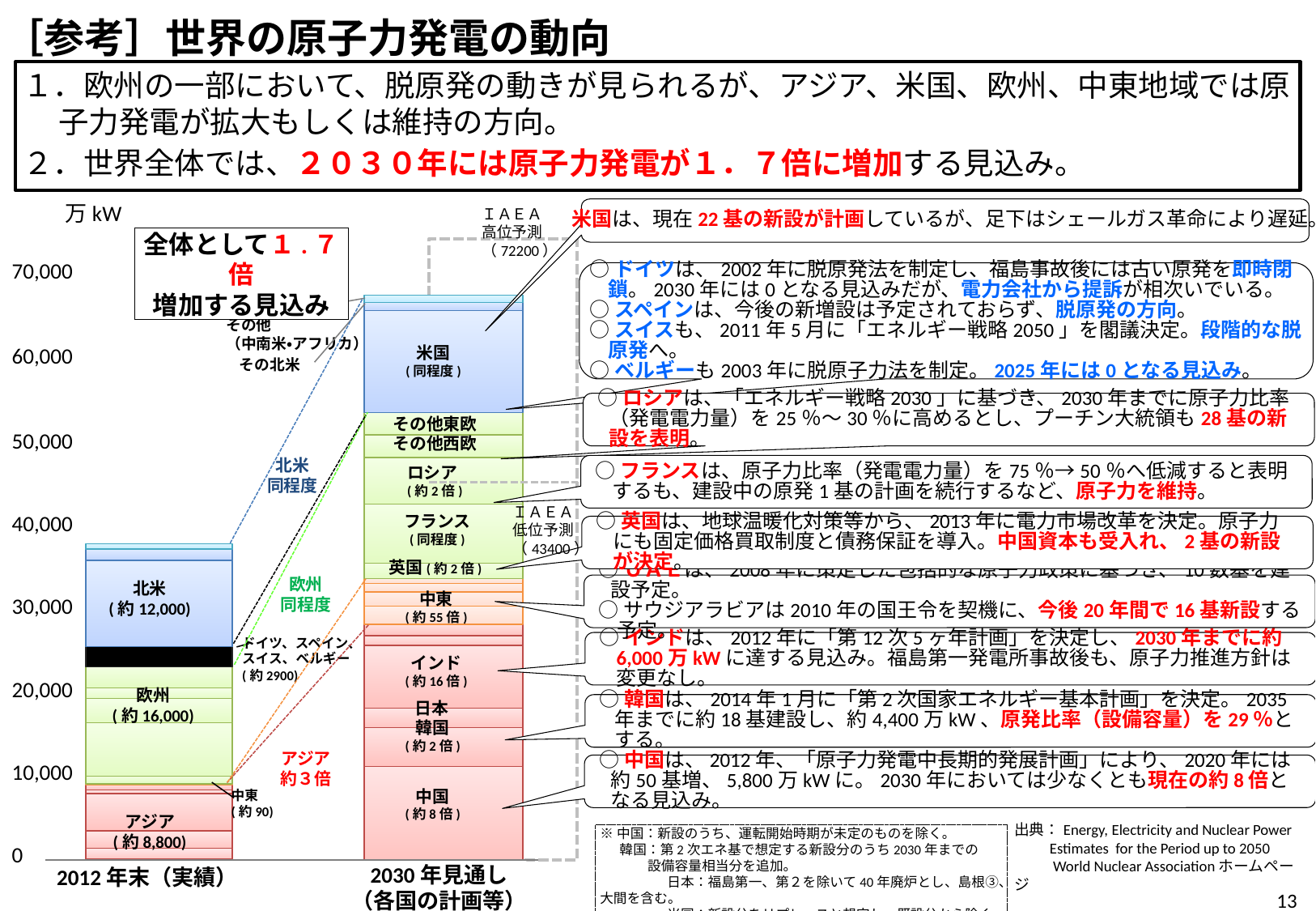
What value is printed for 欧州 in the 2012年末（実績） bar? 約16,000 What value is printed for アジア in the 2012年末（実績） bar? 約8,800 What kind of chart is shown on the slide? stacked bar chart What value is printed for 中東 in the 2012年末（実績） bar? 約90 What unit is shown on the y axis of the chart? 万kW How many bars does the chart show? 2 Is the total of the 2030年見通し bar greater or less than 60,000? greater What value is printed for 北米 in the 2012年末（実績） bar? 約12,000 Which is larger in the 2012年末（実績） bar, 北米 or 欧州? 欧州 What value is printed for the IAEA低位予測 level? 43400 What value is printed for the IAEA高位予測 level? 72200 What is the difference between the IAEA高位予測 (72200) and the IAEA低位予測 (43400)? 28800